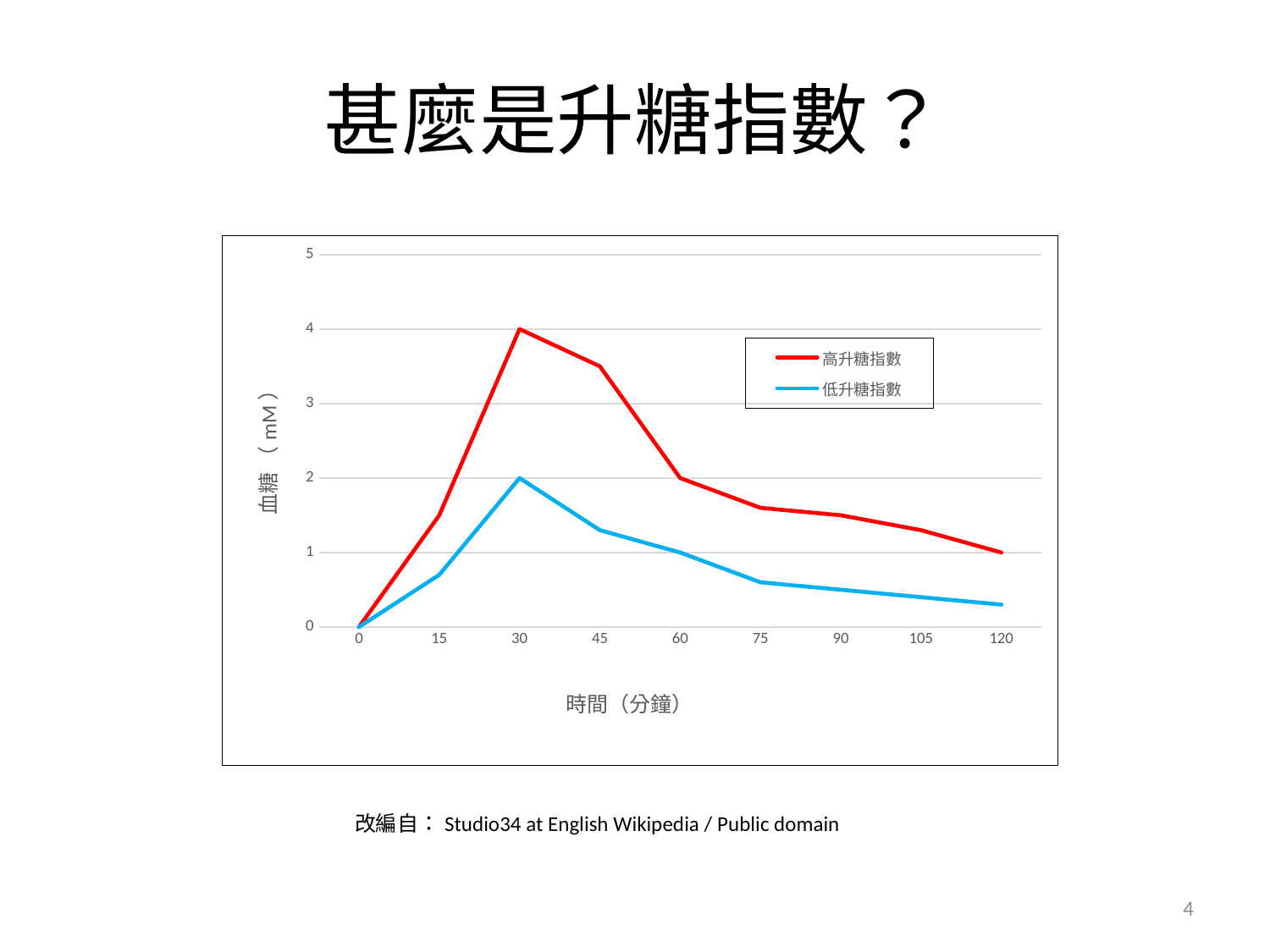
Is the value for 高升糖指數 at 45 minutes greater or less than 3? greater What kind of chart is shown on the slide? line chart At which time (minutes) does 高升糖指數 reach its highest value? 30 What is the difference between 高升糖指數 and 低升糖指數 at 30 minutes? 2 How many series does the legend list? 2 What is the value of 高升糖指數 at 60 minutes? 2 What is the value of 高升糖指數 at 30 minutes? 4 What is the value of 高升糖指數 at 120 minutes? 1 At 45 minutes, which series has the higher value, 高升糖指數 or 低升糖指數? 高升糖指數 Is the value for 低升糖指數 at 75 minutes greater or less than 1? less From 30 minutes to 120 minutes, does the 高升糖指數 line rise or fall? fall What is the value of 低升糖指數 at 30 minutes? 2